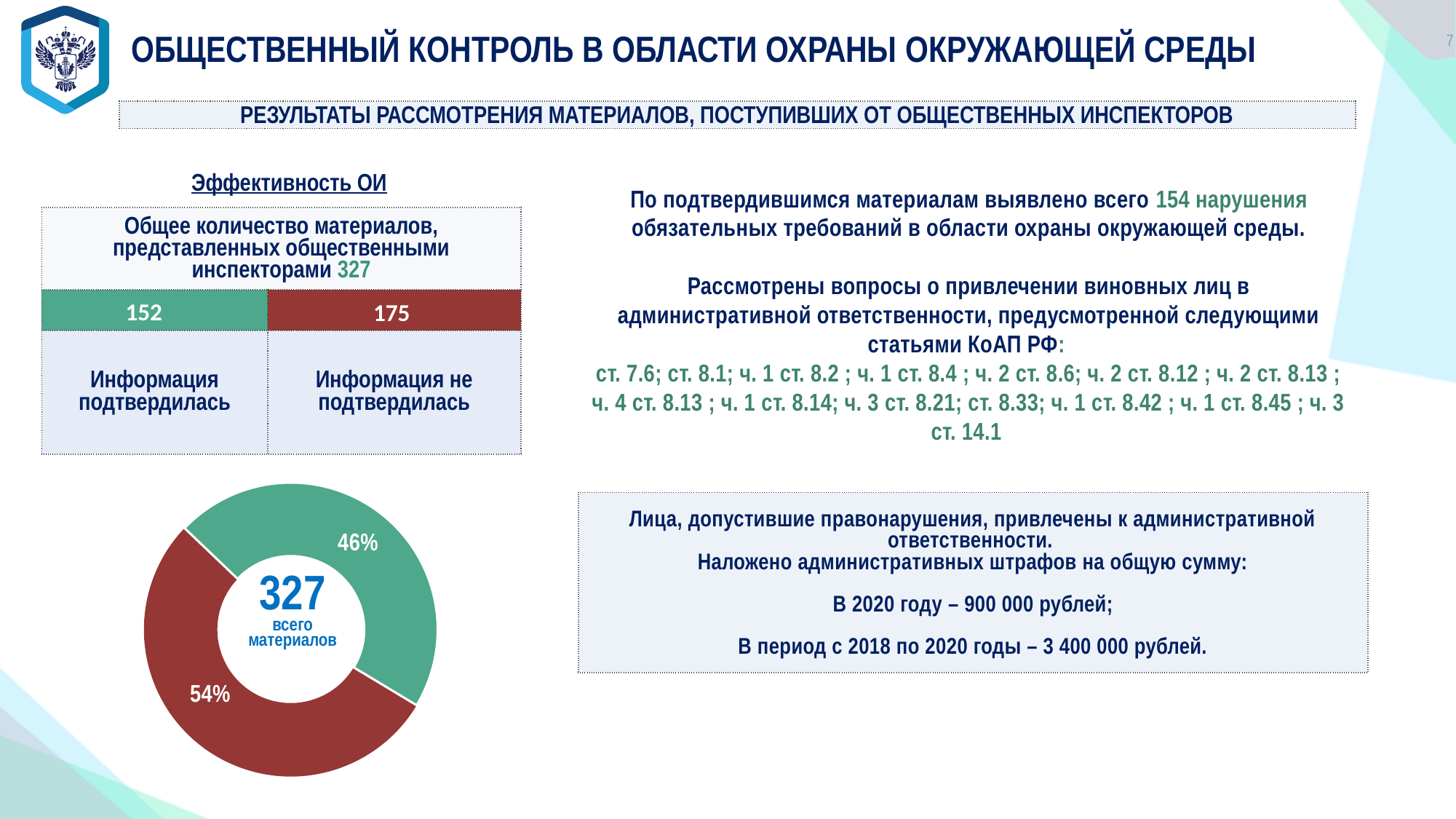
Is the share of the red slice in the donut chart greater or less than 50%? greater Is the share of the green slice in the donut chart greater or less than 50%? less In the donut chart, is the red slice or the green slice larger? The red slice Which slice of the donut chart is the smallest? The green slice (46%) Which slice of the donut chart is the largest? The red slice (54%) What text appears under the number in the centre of the donut chart? всего материалов What total number is shown in the centre of the donut chart? 327 What kind of chart is shown at the bottom left of the slide? Donut (pie) chart What percentage is shown on the green slice of the donut chart? 46% How many slices does the donut chart have? 2 What percentage is shown on the red slice of the donut chart? 54% What is the difference in percentage points between the red and green slices of the donut chart? 8 percentage points